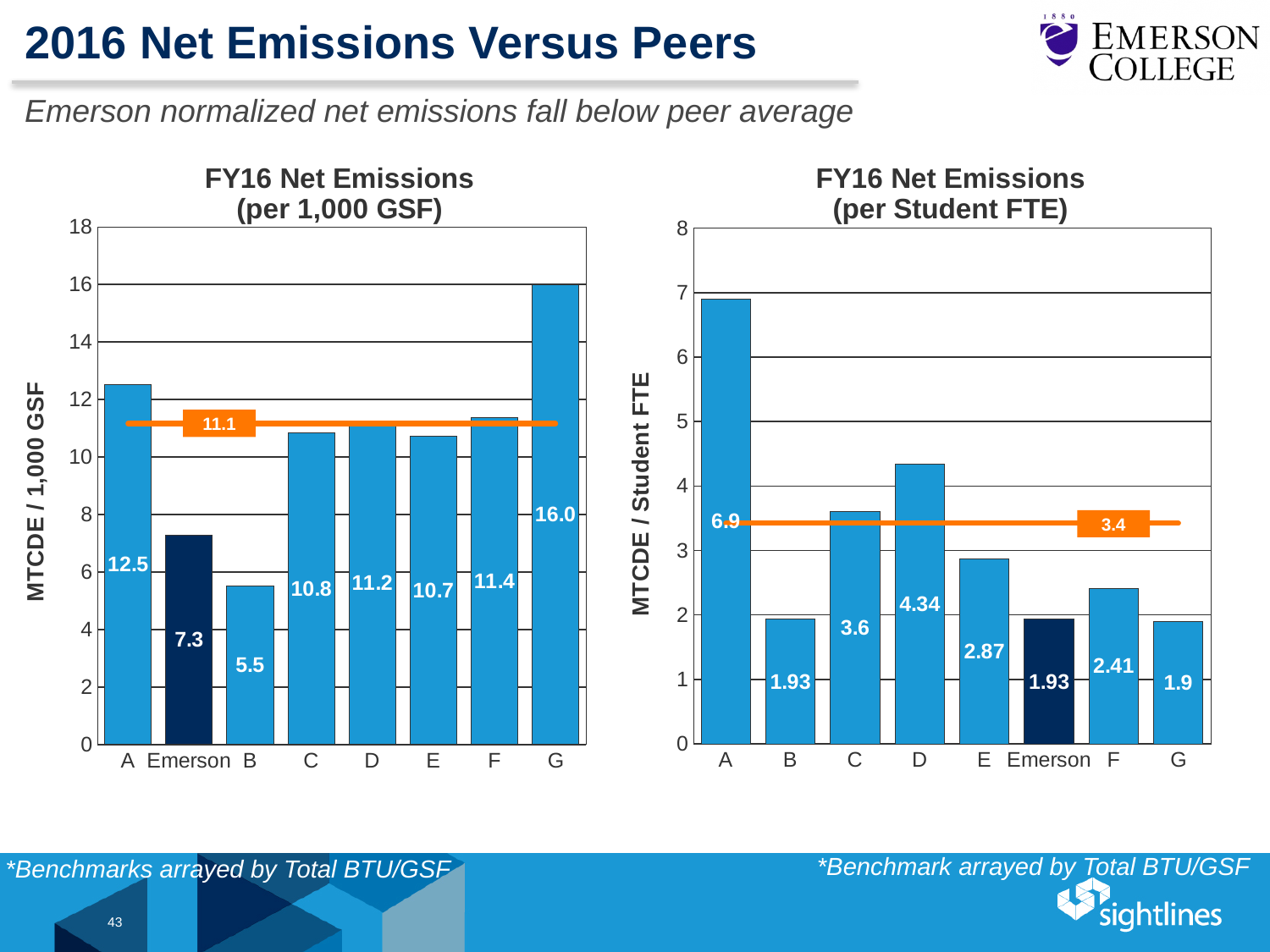
In the FY16 Net Emissions (per Student FTE) chart, what is the difference between the values for A and Emerson? 4.97 In the FY16 Net Emissions (per 1,000 GSF) chart, what is the value for Emerson? 7.3 In the FY16 Net Emissions (per 1,000 GSF) chart, which category has the highest value? G What kind of chart is the FY16 Net Emissions (per Student FTE) chart? Bar chart In the FY16 Net Emissions (per 1,000 GSF) chart, what is the value of the peer average line? 11.1 In the FY16 Net Emissions (per Student FTE) chart, what is the value of the peer average line? 3.4 In the FY16 Net Emissions (per Student FTE) chart, which category has the highest value? A In the FY16 Net Emissions (per 1,000 GSF) chart, which category has the lowest value? B In the FY16 Net Emissions (per Student FTE) chart, what is the value for D? 4.34 In the FY16 Net Emissions (per 1,000 GSF) chart, what is the difference between the values for G and A? 3.5 In the FY16 Net Emissions (per Student FTE) chart, which is larger, the value for C or the value for E? C In the FY16 Net Emissions (per 1,000 GSF) chart, how many bars are plotted? 8